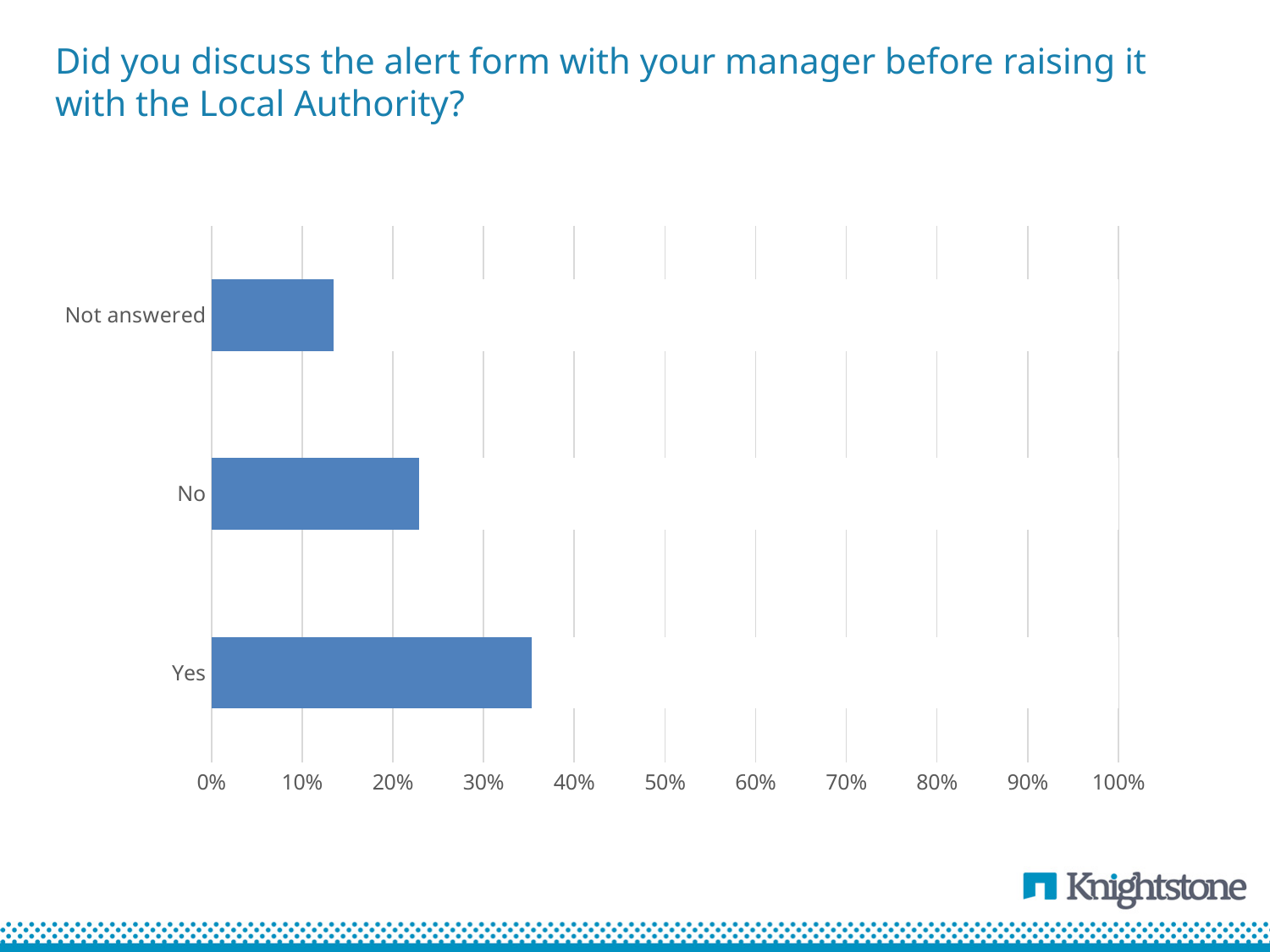
Is the value for Yes greater or less than 40%? less Which is larger, the value for Yes or the value for No? Yes How many categories are shown in the chart? 3 Which category has the lowest value? Not answered Is the value for Not answered greater or less than 20%? less Which is larger, the value for No or the value for Not answered? No Is the value for Yes greater or less than 30%? greater What kind of chart is shown on the slide? Bar chart What is the title of the slide? Did you discuss the alert form with your manager before raising it with the Local Authority? Which category has the highest value? Yes